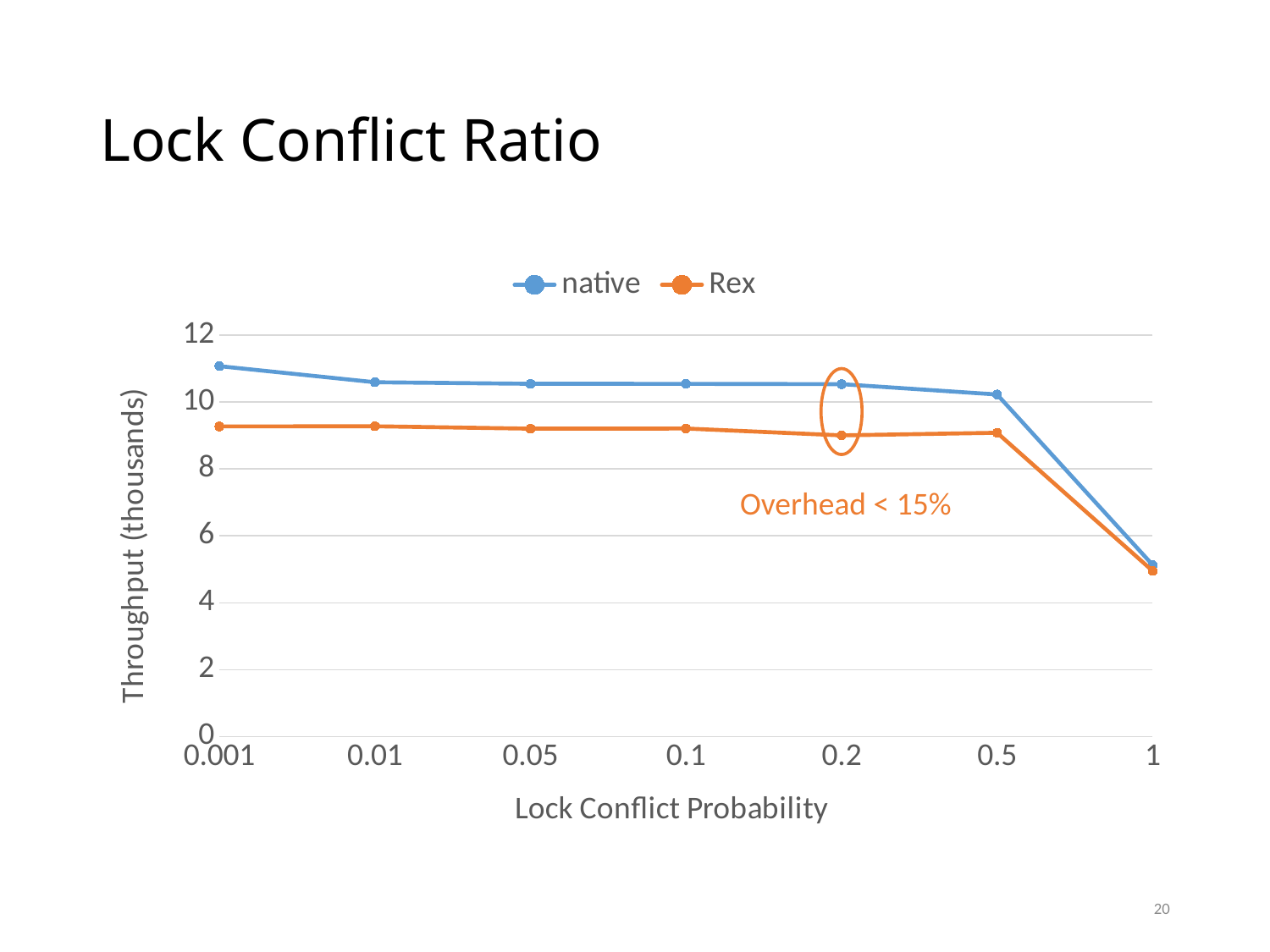
What is the label of the y axis? Throughput (thousands) Does the native throughput rise or fall as lock conflict probability increases from 0.001 to 1? fall At which lock conflict probability is the Rex throughput lowest? 1 How many lock conflict probability values are plotted along the x axis? 7 Is the native throughput at lock conflict probability 0.001 greater or less than 10? greater Is the Rex throughput at lock conflict probability 0.001 greater or less than 10? less At lock conflict probability 0.001, which series has the higher throughput, native or Rex? native At which lock conflict probability is the native throughput highest? 0.001 What kind of chart is shown on the slide? line chart Is the native throughput at lock conflict probability 1 greater or less than 6? less How many series does the legend list? 2